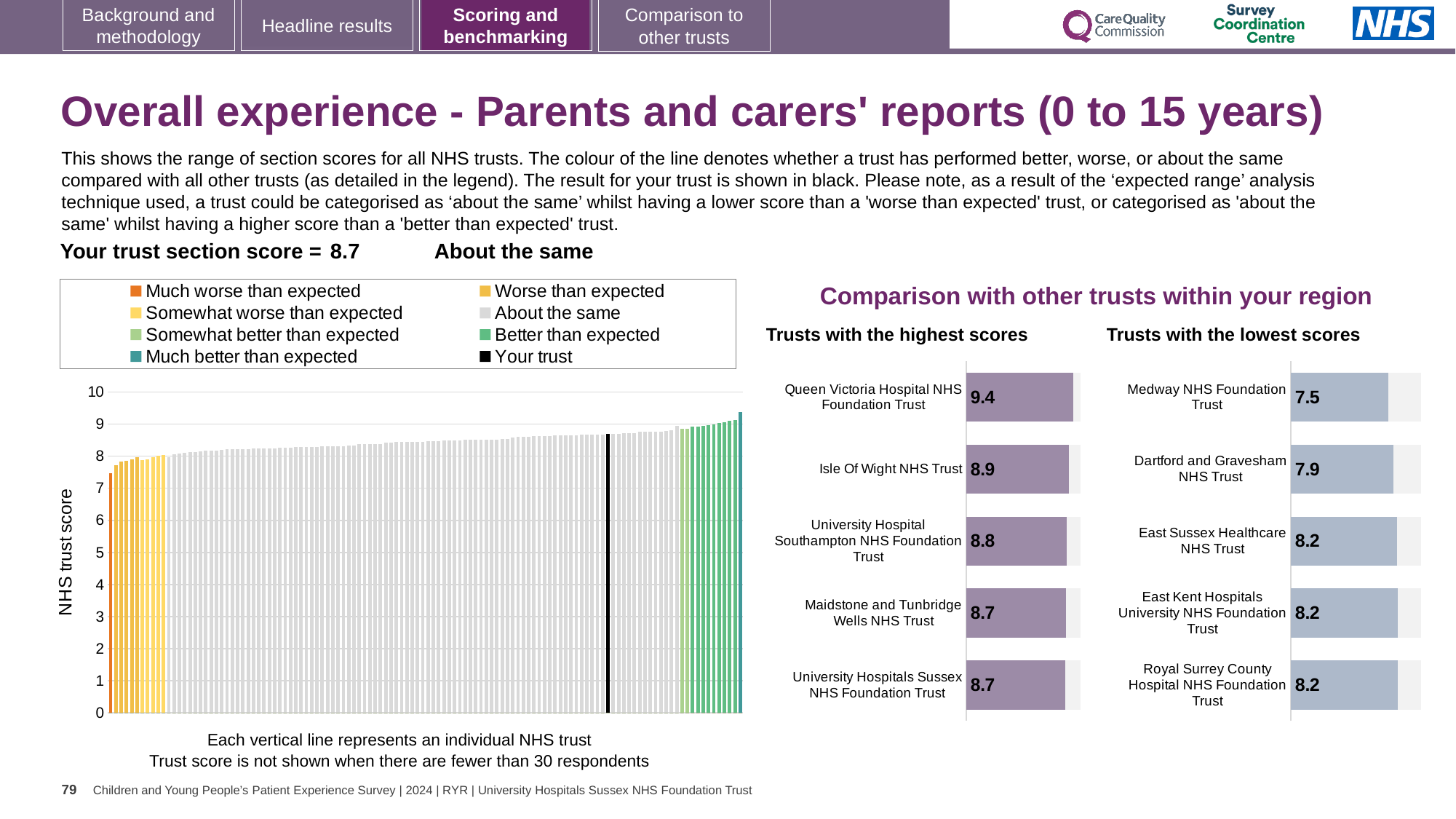
In the large chart on the left, how many entries does the legend list? 8 In the 'Trusts with the highest scores' chart, what is the score for Queen Victoria Hospital NHS Foundation Trust? 9.4 In the 'Trusts with the highest scores' chart, what is the difference between the scores of Queen Victoria Hospital NHS Foundation Trust and Isle Of Wight NHS Trust? 0.5 In the 'Trusts with the lowest scores' chart, what is the score for Medway NHS Foundation Trust? 7.5 In the 'Trusts with the lowest scores' chart, which trust has the lowest score? Medway NHS Foundation Trust In the large chart on the left, is the value for the black bar (Your trust) greater or less than 8? greater In the 'Trusts with the highest scores' chart, how many trusts are shown? 5 In the 'Trusts with the lowest scores' chart, which has the larger score: Medway NHS Foundation Trust or Dartford and Gravesham NHS Trust? Dartford and Gravesham NHS Trust In the large chart on the left, do the bar values rise or fall from left to right along the x axis? rise In the 'Trusts with the highest scores' chart, which trust has the highest score? Queen Victoria Hospital NHS Foundation Trust In the large chart on the left, what is the label on the vertical axis? NHS trust score What kind of chart is the large chart on the left showing NHS trust scores? bar chart